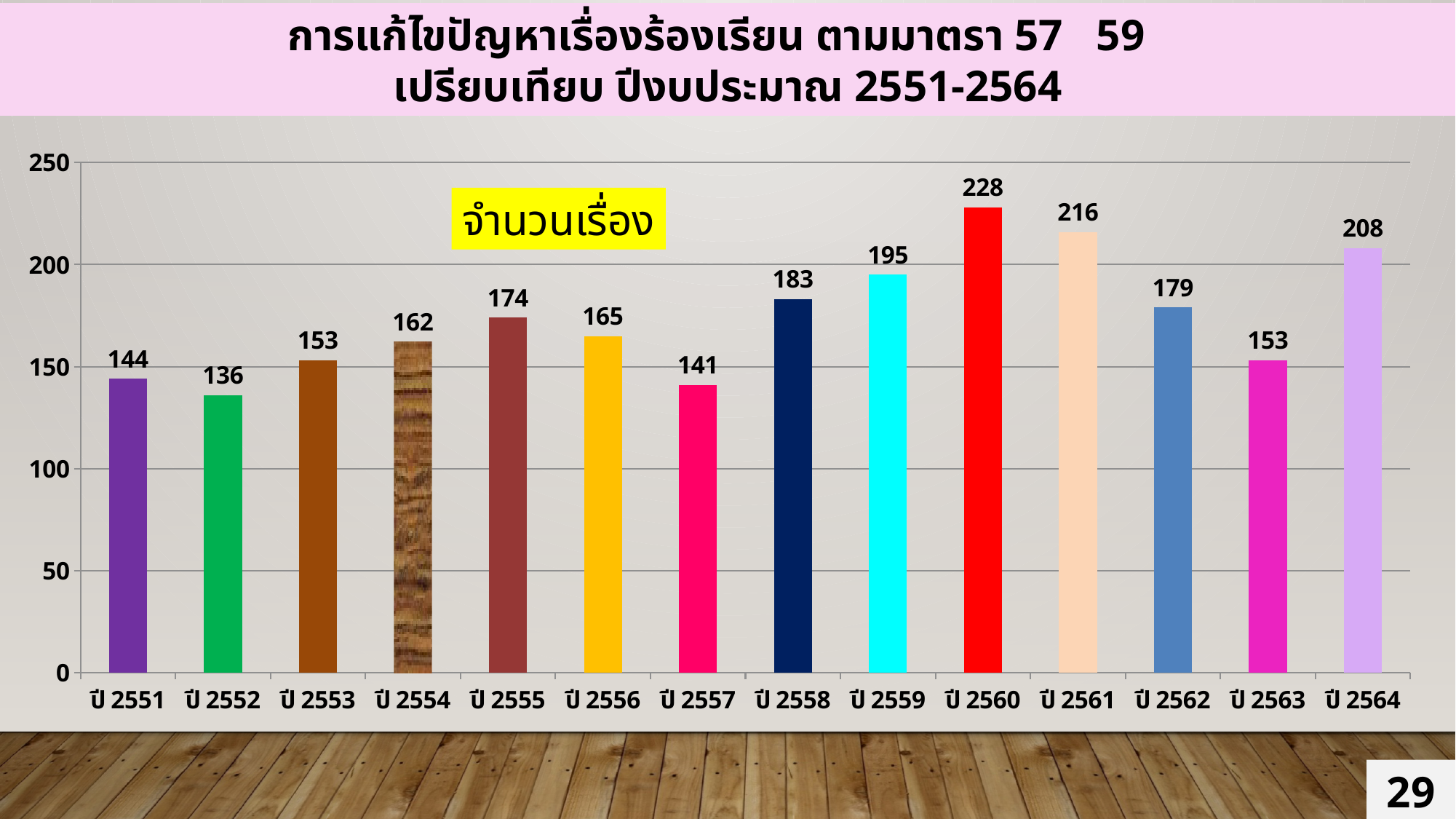
What is the value for ปี 2560? 228 What is the value for ปี 2551? 144 What is the difference between the values for ปี 2559 and ปี 2558? 12 What text appears in the yellow highlighted label inside the chart? จำนวนเรื่อง Which is larger, the value for ปี 2555 or the value for ปี 2556? ปี 2555 What is the difference between the values for ปี 2560 and ปี 2561? 12 Which year has the lowest value? ปี 2552 Which year has the highest value? ปี 2560 What kind of chart is shown on the slide? bar chart Is the value for ปี 2562 greater or less than 150? greater What is the value for ปี 2564? 208 How many years are shown on the x axis? 14